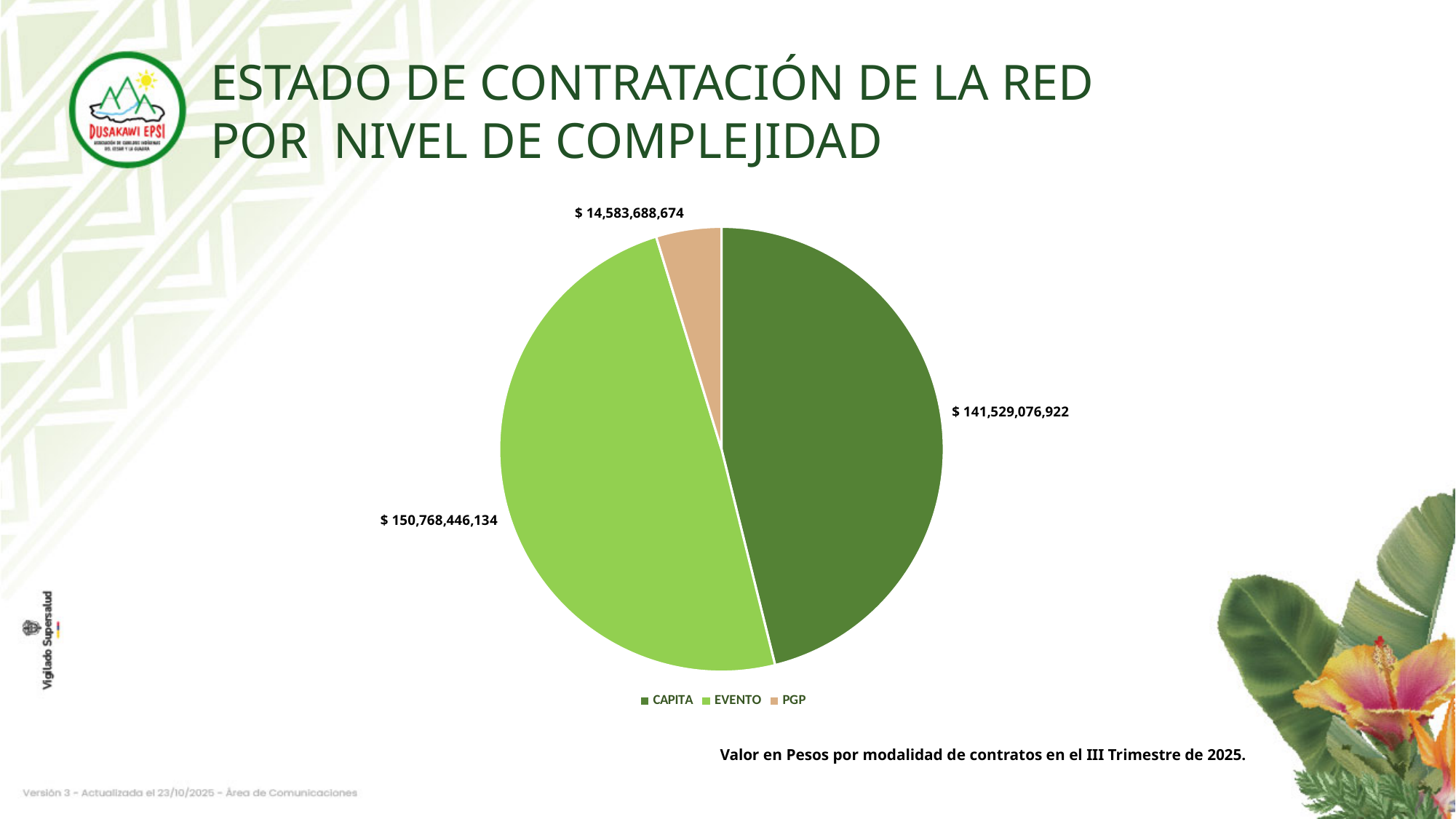
What is the value of the EVENTO slice? $ 150,768,446,134 Which is larger, the CAPITA value or the PGP value? CAPITA Which contract modality has the largest value in the pie chart? EVENTO What kind of chart is shown on the slide? Pie chart What is the difference between the CAPITA and PGP values? $ 126,945,388,248 How many entries does the legend list? 3 What is the value of the CAPITA slice? $ 141,529,076,922 What is the total of all three slices in the pie chart? $ 306,881,211,730 What is the value of the PGP slice? $ 14,583,688,674 How many slices does the pie chart have? 3 Which contract modality has the smallest value in the pie chart? PGP What is the difference between the EVENTO and CAPITA values? $ 9,239,369,212